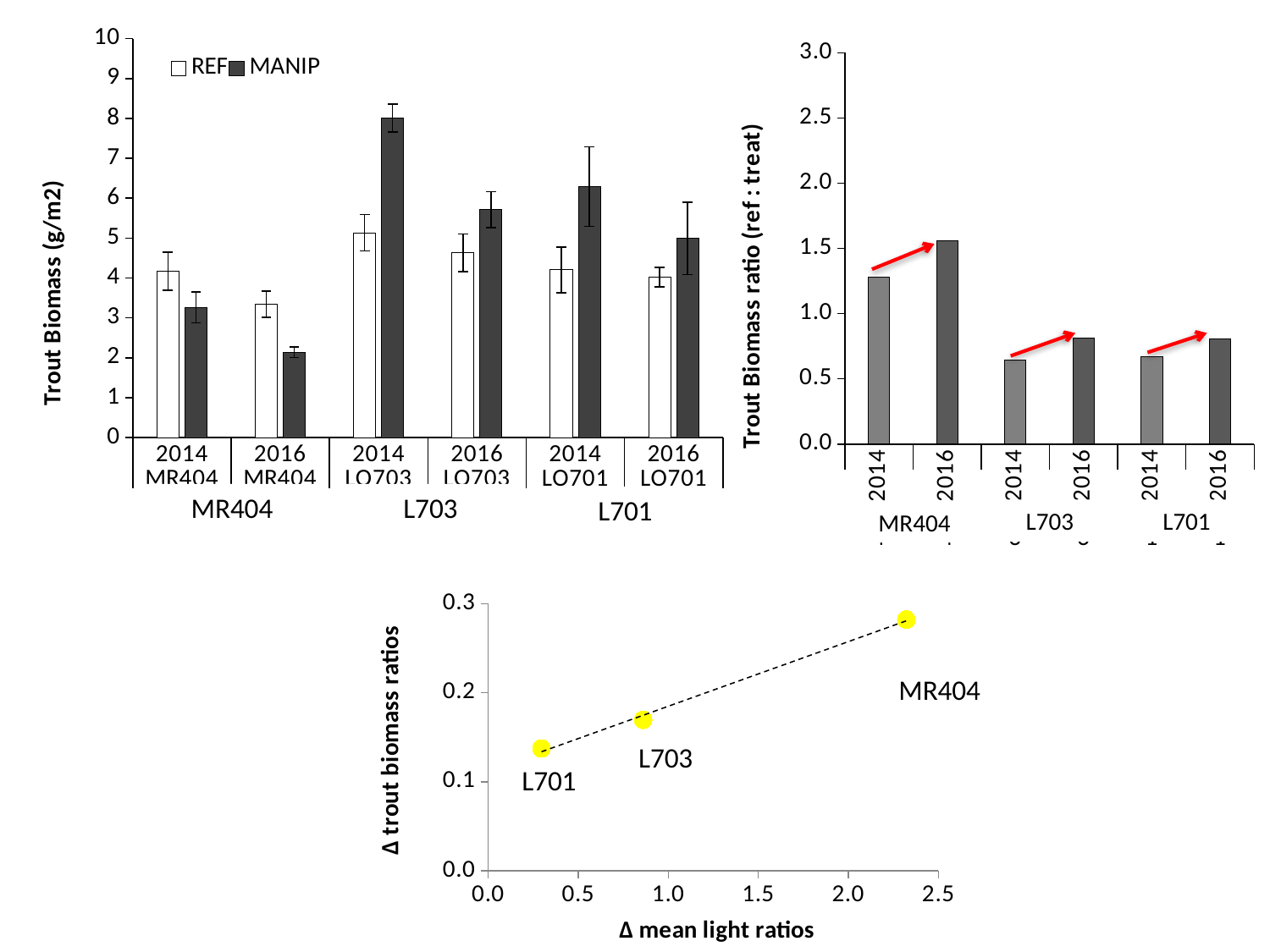
In the top-right chart (Trout Biomass ratio), which bar is the highest? 2016 MR404 In the bottom chart (Δ trout biomass ratios vs Δ mean light ratios), how many data points are plotted? 3 In the bottom chart (Δ trout biomass ratios vs Δ mean light ratios), is the Δ mean light ratio for MR404 greater or less than 2.0? greater In the top-left chart (Trout Biomass g/m2), which bar is the highest? MANIP, 2014 L703 In the top-right chart (Trout Biomass ratio), is the value for 2014 MR404 greater or less than 1.0? greater In the top-left chart (Trout Biomass g/m2), is the MANIP value for 2014 L703 greater or less than 7? greater In the top-left chart (Trout Biomass g/m2), for 2014 L701, which is larger, REF or MANIP? MANIP In the top-left chart (Trout Biomass g/m2), how many series does the legend list? 2 In the top-right chart (Trout Biomass ratio), does the ratio for each lake rise or fall from 2014 to 2016? rise In the top-left chart (Trout Biomass g/m2), for 2014 MR404, which is larger, REF or MANIP? REF